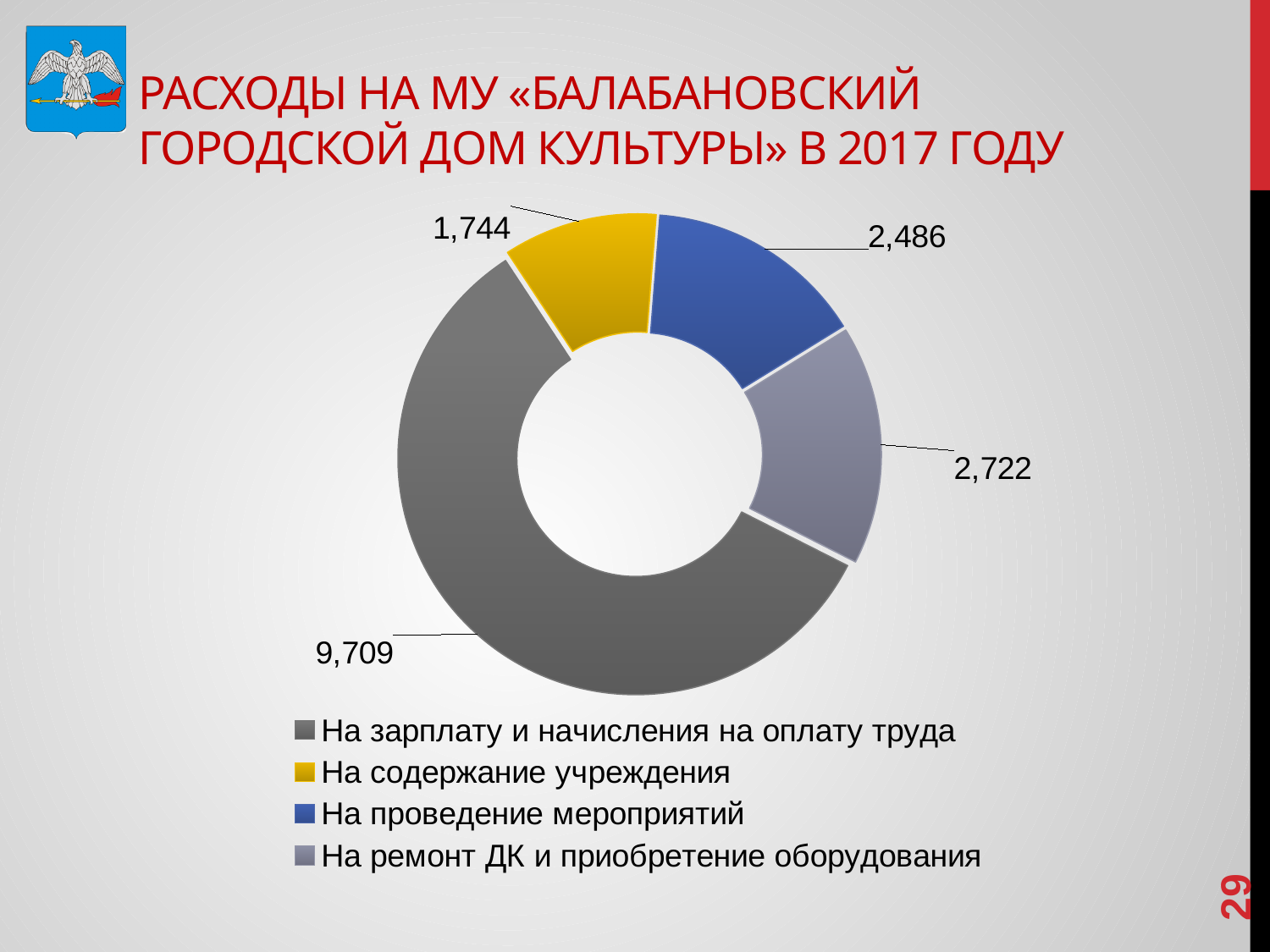
What is the value for «На зарплату и начисления на оплату труда»? 9,709 What is the value for «На проведение мероприятий»? 2,486 Which is larger: «На проведение мероприятий» or «На ремонт ДК и приобретение оборудования»? На ремонт ДК и приобретение оборудования What kind of chart is shown on the slide? Doughnut (pie) chart Which category has the smallest value? На содержание учреждения What is the value for «На содержание учреждения»? 1,744 How many categories does the chart show? 4 What is the difference between the values for «На зарплату и начисления на оплату труда» and «На содержание учреждения»? 7,965 What colour represents «На содержание учреждения» in the chart? Yellow What is the difference between the values for «На ремонт ДК и приобретение оборудования» and «На проведение мероприятий»? 236 Which category has the largest value? На зарплату и начисления на оплату труда What is the value for «На ремонт ДК и приобретение оборудования»? 2,722